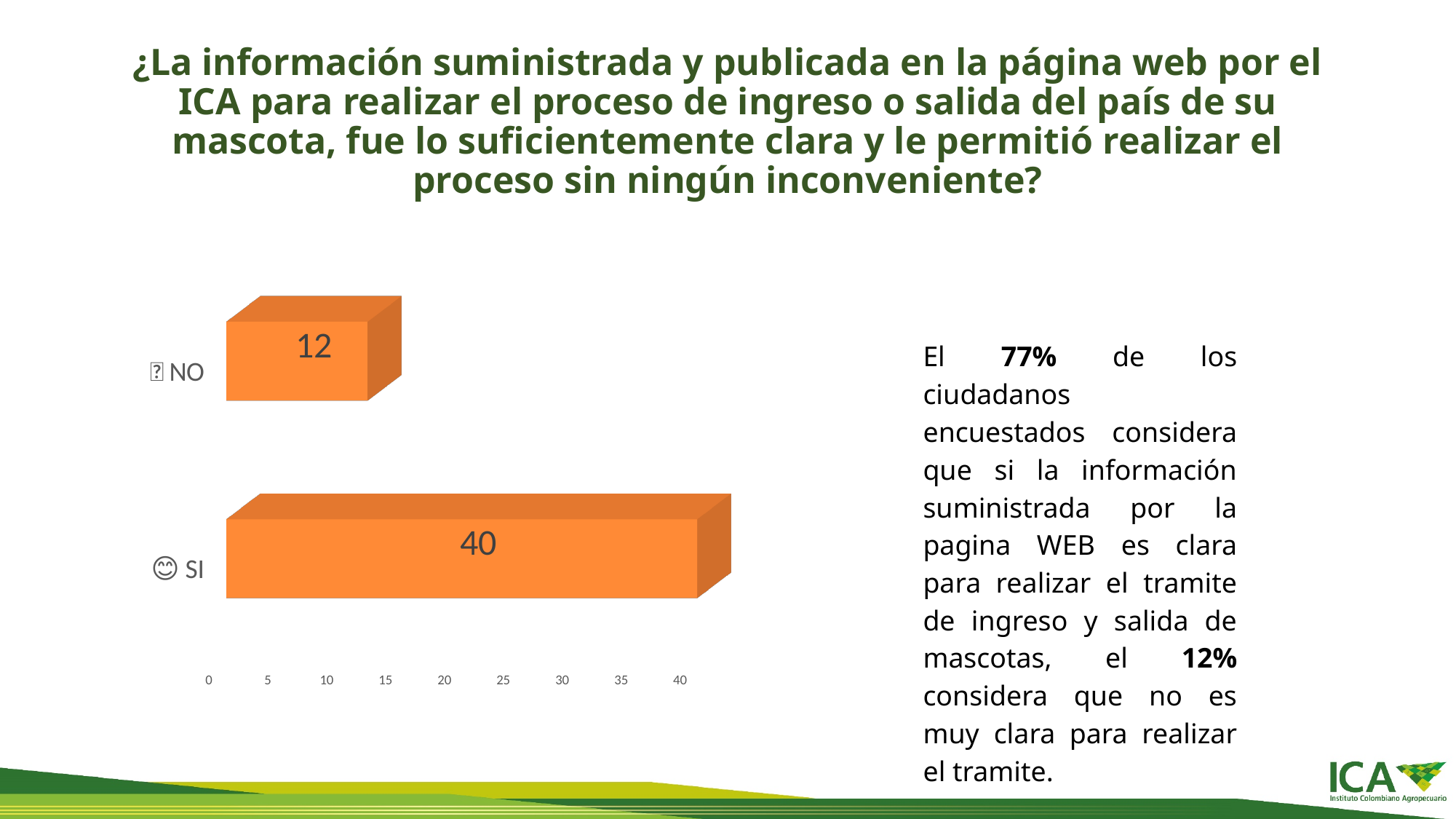
What is the difference between the values for SI and NO? 28 How many categories are shown in the chart? 2 What is the value for NO? 12 Is the value for SI greater or less than 35? greater What is the highest tick value shown on the horizontal axis? 40 Which is larger, the value for SI or the value for NO? SI What is the value for SI? 40 What colour are the bars in the chart? orange Is the value for NO greater or less than 20? less Which category has the lowest value? NO Which category has the highest value? SI What kind of chart is shown on the slide? bar chart